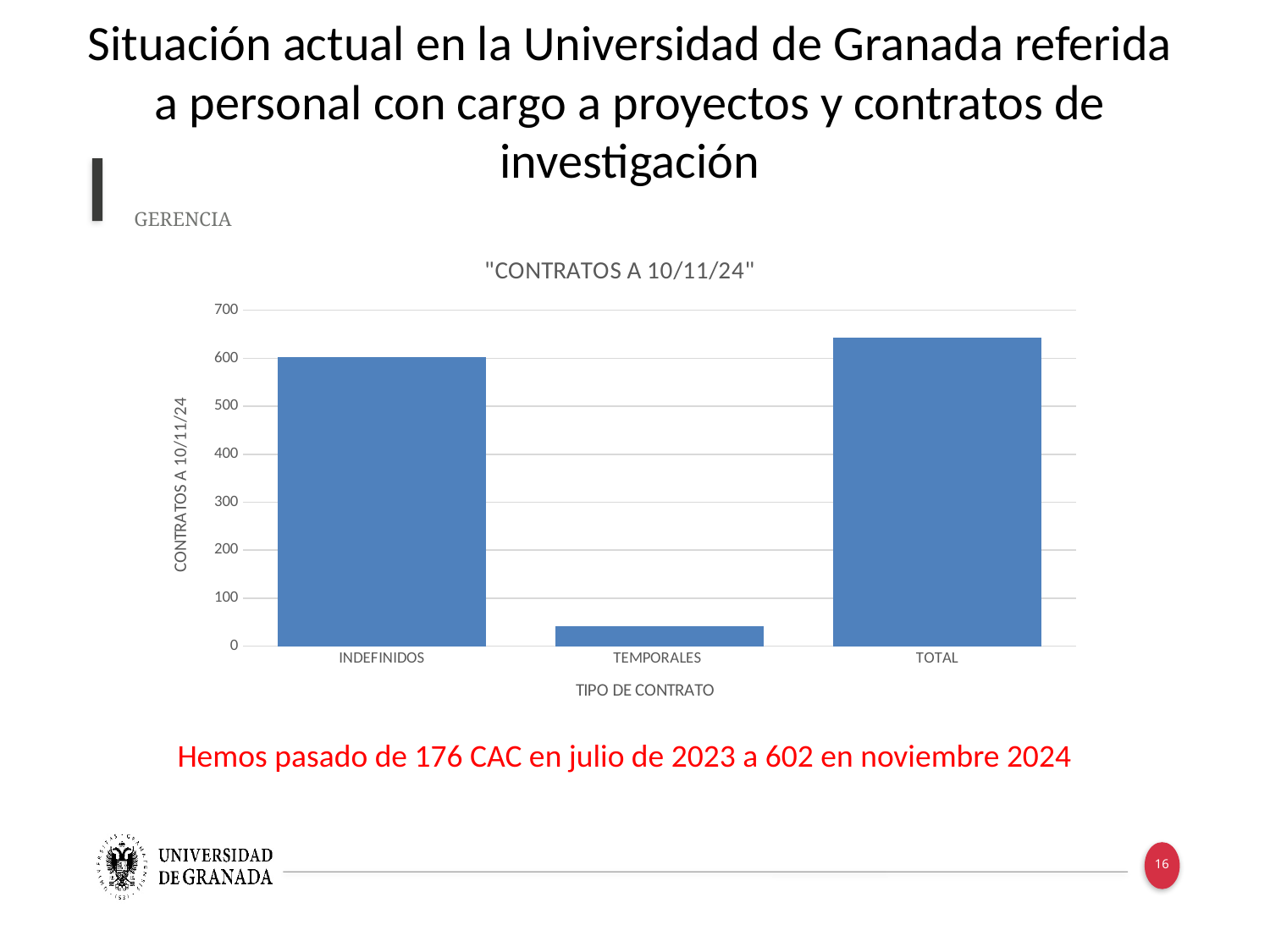
Is the value for TEMPORALES greater or less than 100? less Which category has the lowest bar in the chart? TEMPORALES Which category has the highest bar in the chart? TOTAL Is the value for INDEFINIDOS greater or less than 700? less What kind of chart is shown on the slide? bar chart Is the value for TOTAL greater or less than 600? greater How many categories are shown on the x axis of the chart? 3 What is the label of the x axis of the chart? TIPO DE CONTRATO What is the title of the chart? "CONTRATOS A 10/11/24" Which is larger, the value for INDEFINIDOS or the value for TEMPORALES? INDEFINIDOS